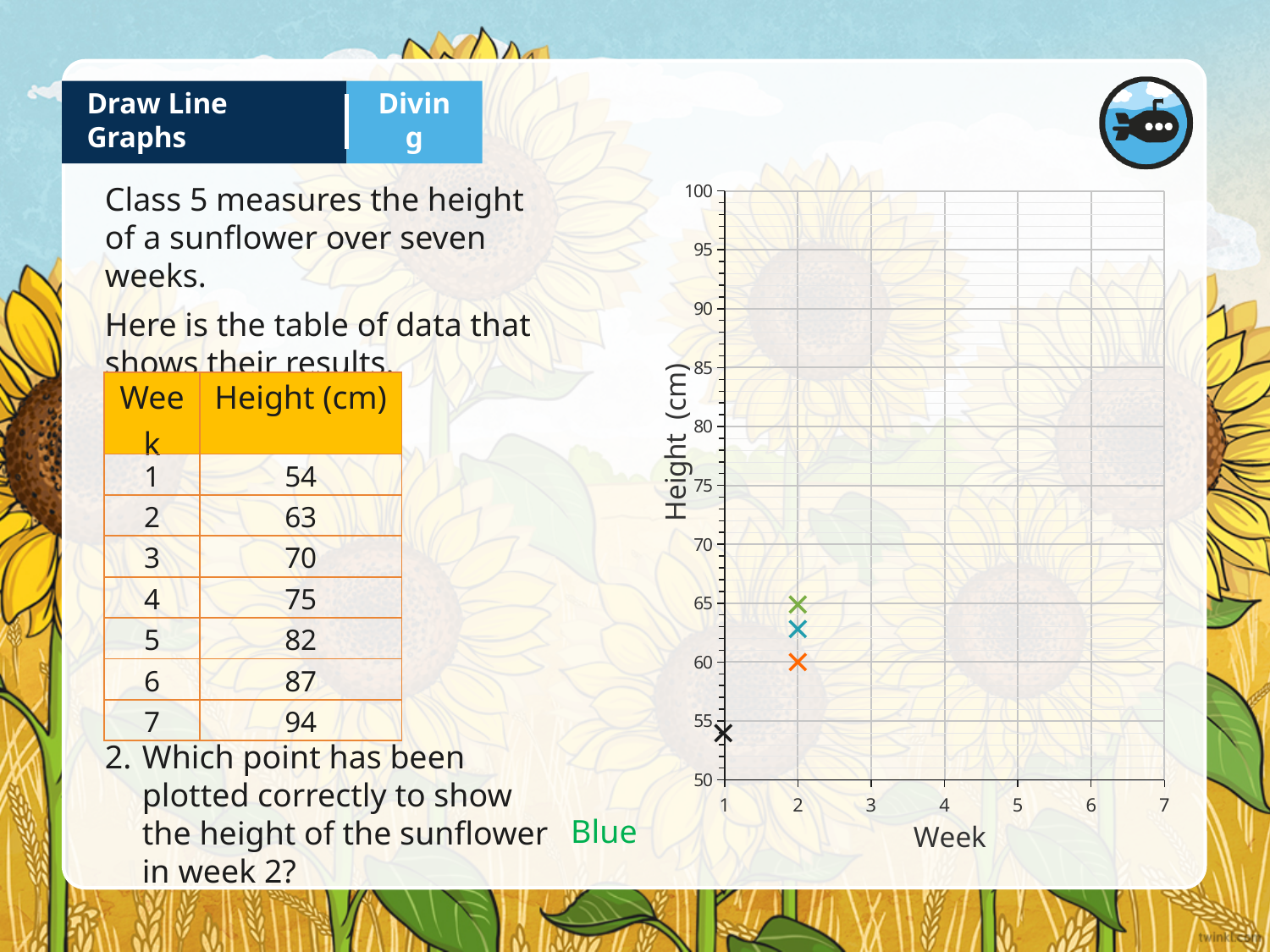
What is the difference in height between the green point and the orange point at week 2? 5 What height does the green point at week 2 show? 65 What is the label of the vertical axis of the chart? Height (cm) How many points are plotted at week 2 on the chart? 3 How many points are plotted on the chart in total? 4 What is the label of the horizontal axis of the chart? Week Is the value of the blue point at week 2 greater or less than 65? less Of the three points plotted at week 2, which colour is the highest? green Of the three points plotted at week 2, which colour is the lowest? orange What kind of chart is shown on the slide? scatter chart What height does the orange point at week 2 show? 60 Is the value of the black point at week 1 greater or less than 60? less